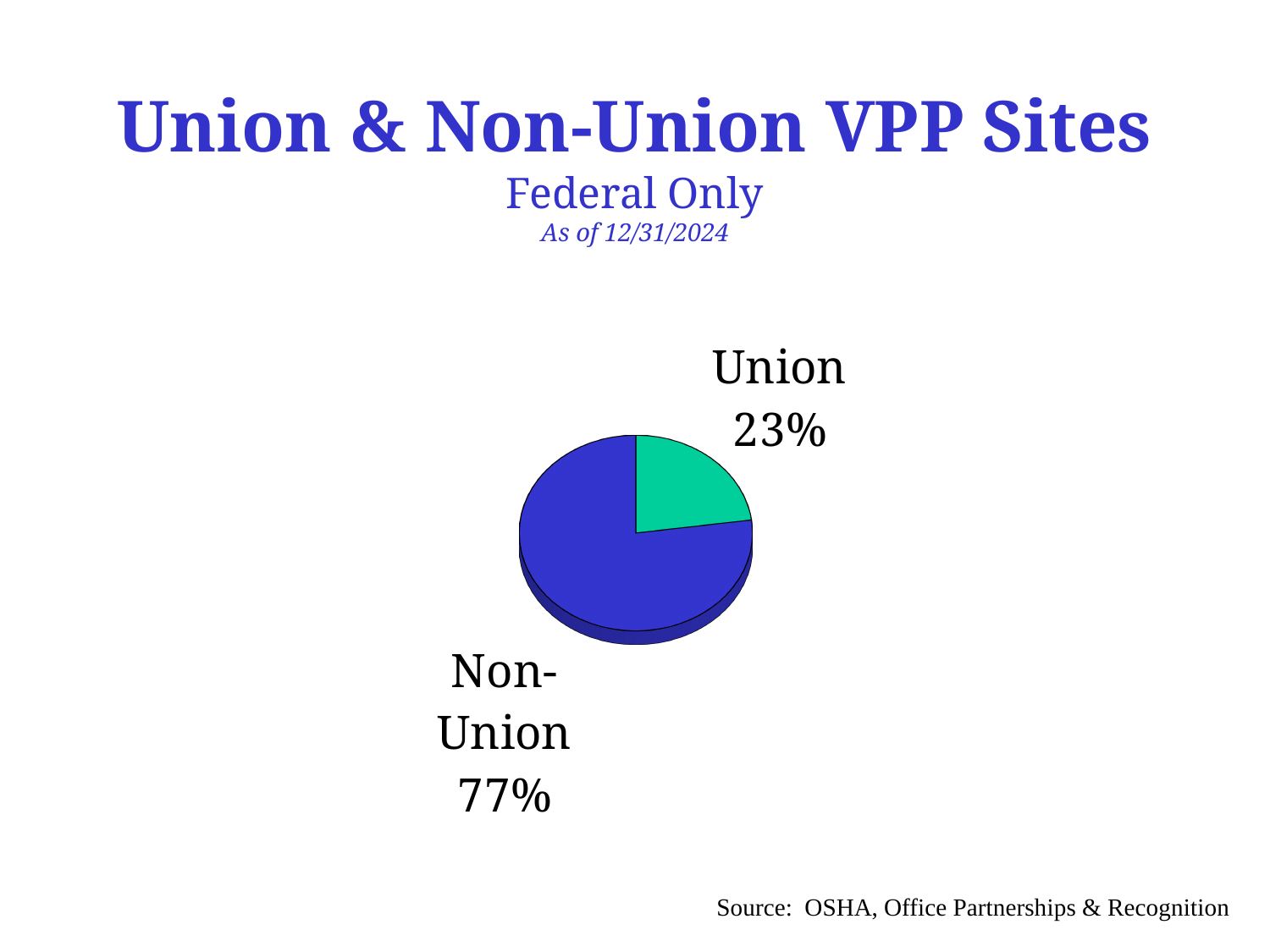
As of what date is the data on the slide reported? 12/31/2024 Which category has the largest share of the pie? Non-Union What share of the pie does the Union slice represent? 23% What colour is the Union slice of the pie? Green Which category has the smallest share of the pie? Union What is the difference in percentage points between the Non-Union and Union shares? 54 What percentage of federal VPP sites are Non-Union? 77% What percentage of federal VPP sites are Union? 23% What type of chart is shown on the slide? Pie chart How many slices does the pie chart have? 2 Which is larger, the Union share or the Non-Union share? Non-Union What is the title of the chart on the slide? Union & Non-Union VPP Sites